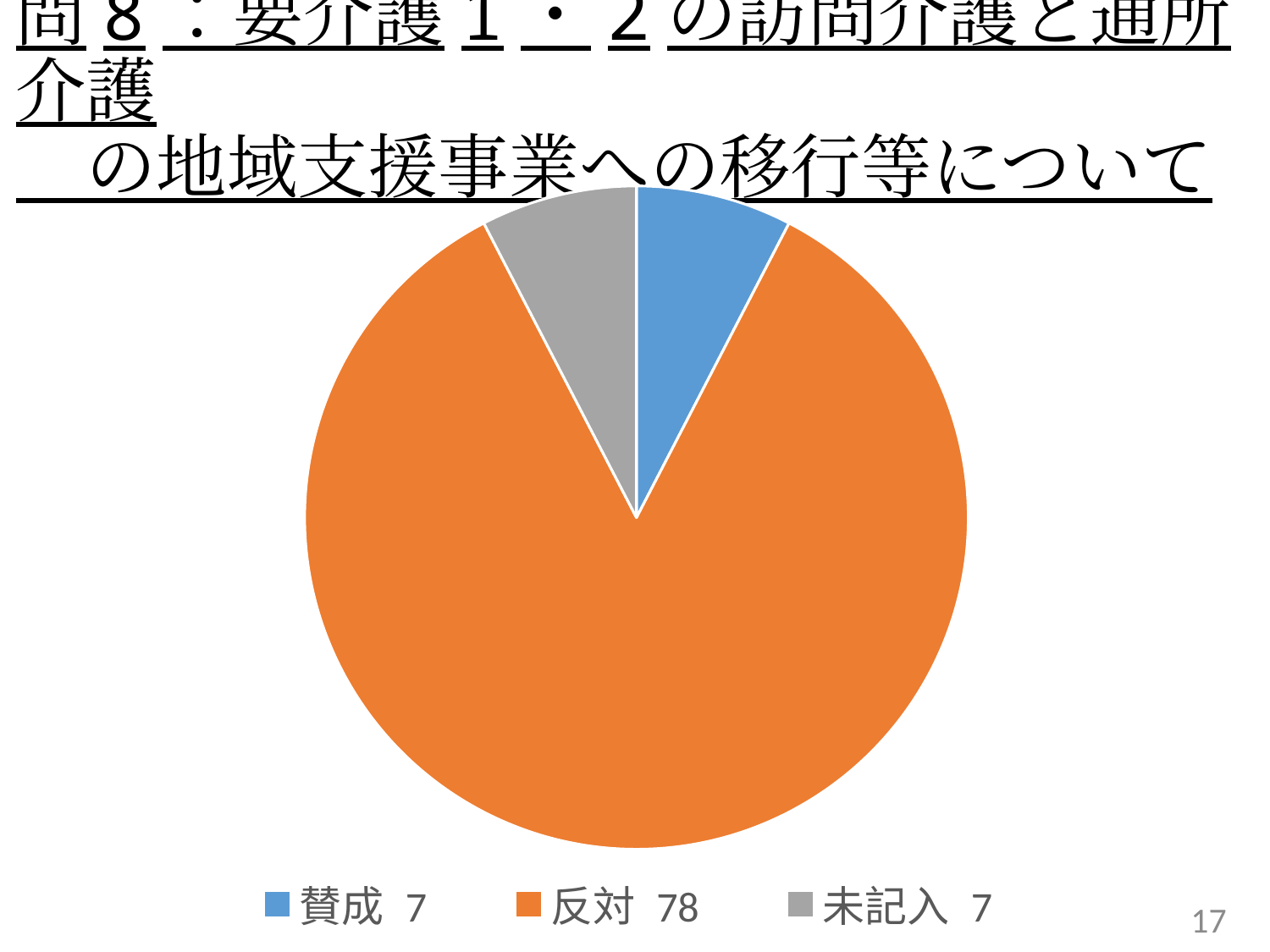
How many categories does the pie chart show? 3 What is the value for 反対 in the pie chart? 78 Is the value for 反対 larger or smaller than the value for 未記入? larger Which category has the largest slice of the pie chart? 反対 Which colour represents 反対 in the pie chart? orange What is the total of all the values shown in the pie chart legend? 92 What is the value for 未記入 in the pie chart? 7 Which colour represents 賛成 in the pie chart? blue What is the value for 賛成 in the pie chart? 7 What kind of chart is shown on the slide? pie chart What is the difference between the values for 反対 and 賛成? 71